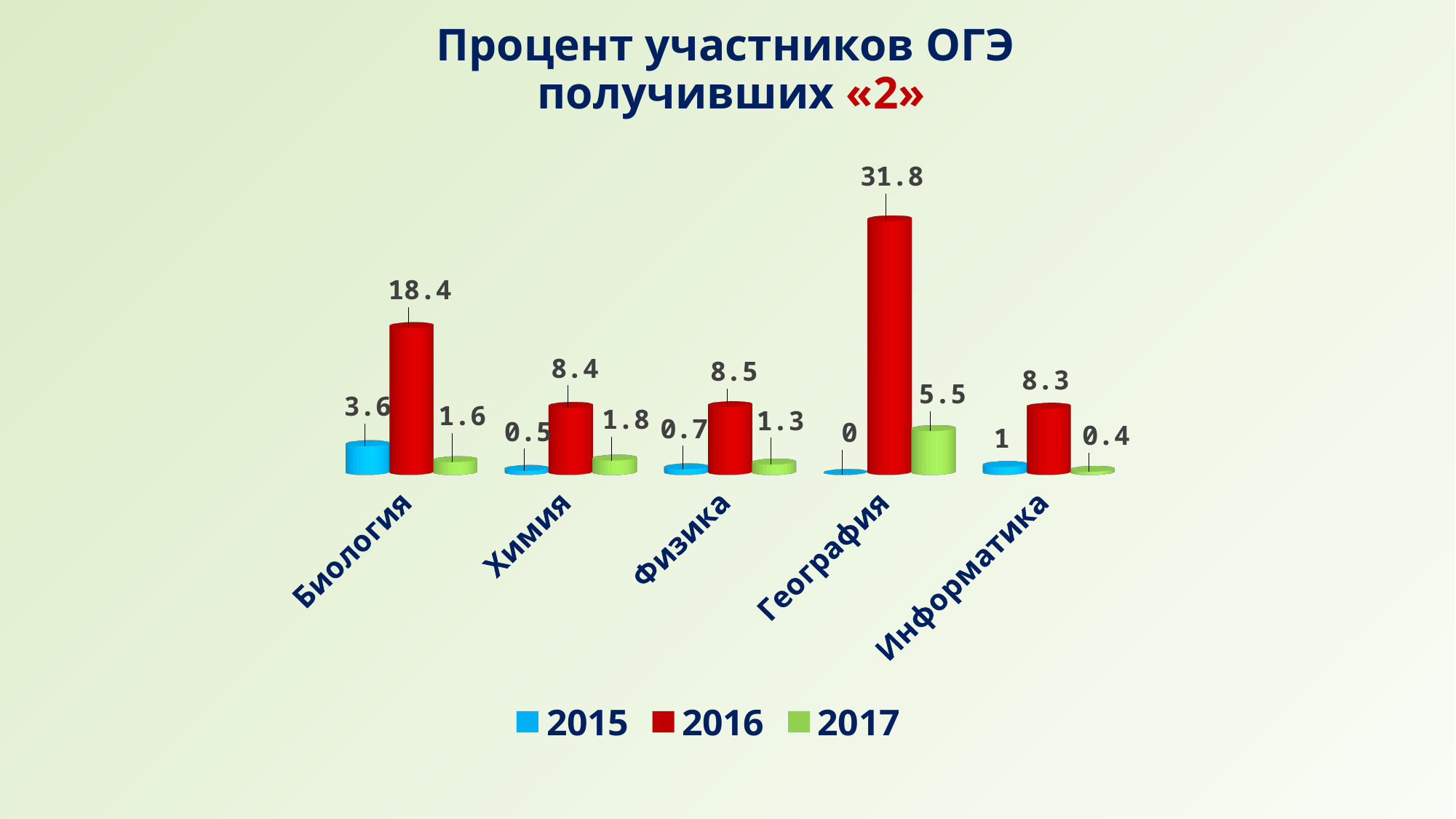
What is the value for Химия in 2017? 1.8 What is the value for Биология in 2016? 18.4 Which is larger, the 2016 value for Физика or the 2016 value for Химия? Физика How many subjects are shown on the x axis? 5 What kind of chart is shown on the slide? Bar chart What is the difference between the 2016 and 2017 values for Биология? 16.8 What is the value for География in 2017? 5.5 Which subject has the highest value in 2016? География What is the value for Информатика in 2015? 1 Which colour represents the 2017 series in the legend? Green Which subject has the lowest value in 2015? География How many series does the legend list? 3